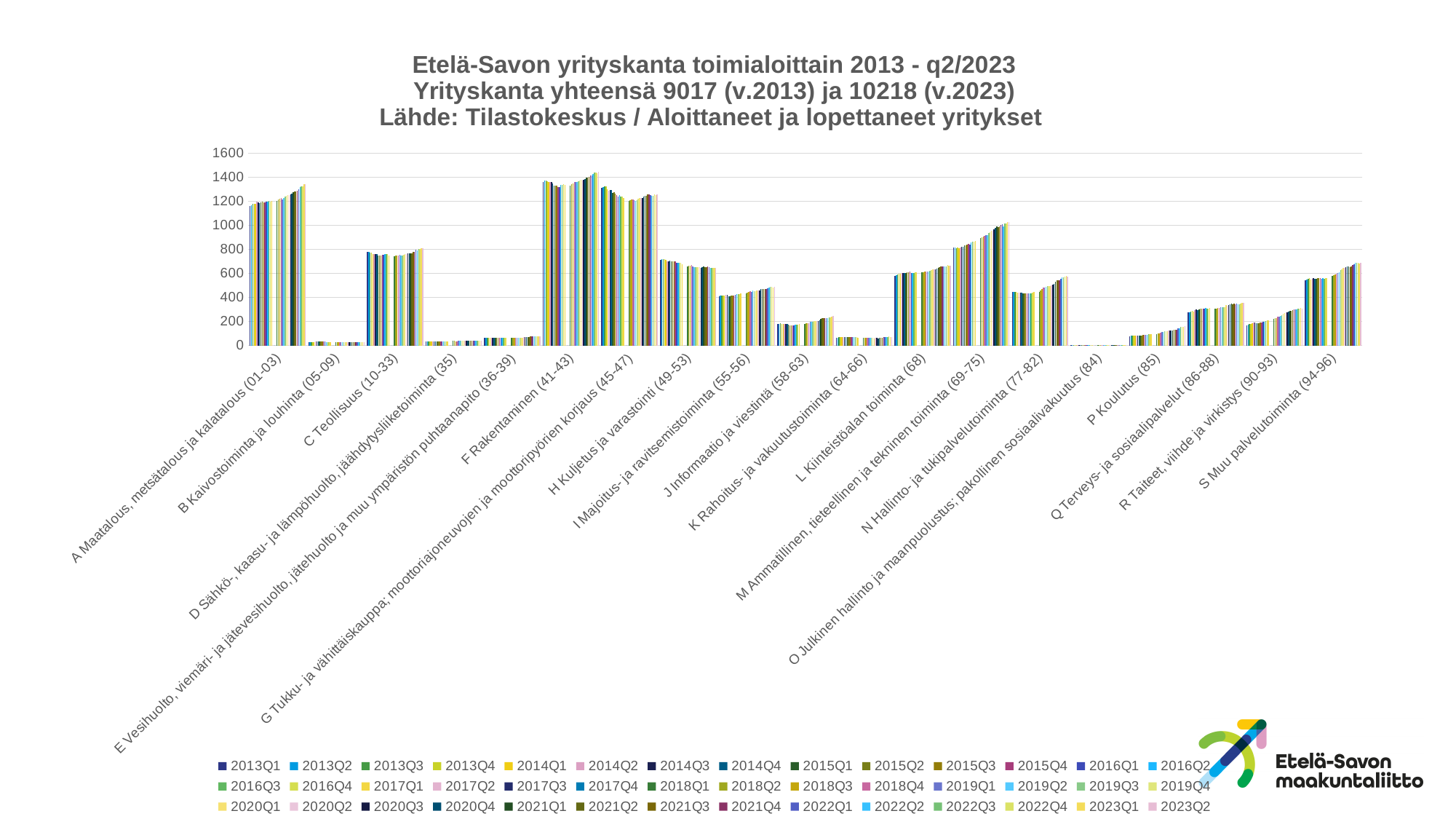
Are the values for C Teollisuus (10-33) greater or less than 1000? less Which industry category has the highest bars in the chart? F Rakentaminen (41-43) Which industry category has the lowest bars in the chart? O Julkinen hallinto ja maanpuolustus; pakollinen sosiaalivakuutus (84) According to the chart title, what was the total number of companies (yrityskanta yhteensä) in 2023? 10218 Which has larger values, M Ammatillinen, tieteellinen ja tekninen toiminta (69-75) or N Hallinto- ja tukipalvelutoiminta (77-82)? M Ammatillinen, tieteellinen ja tekninen toiminta (69-75) Are the values for S Muu palvelutoiminta (94-96) greater or less than 400? greater Do the values for A Maatalous, metsätalous ja kalatalous (01-03) rise or fall from 2013Q1 to 2023Q2? rise What kind of chart is shown on the slide? bar chart Are the values for P Koulutus (85) greater or less than 200? less How many series does the legend list? 42 How many industry categories are shown along the x axis? 19